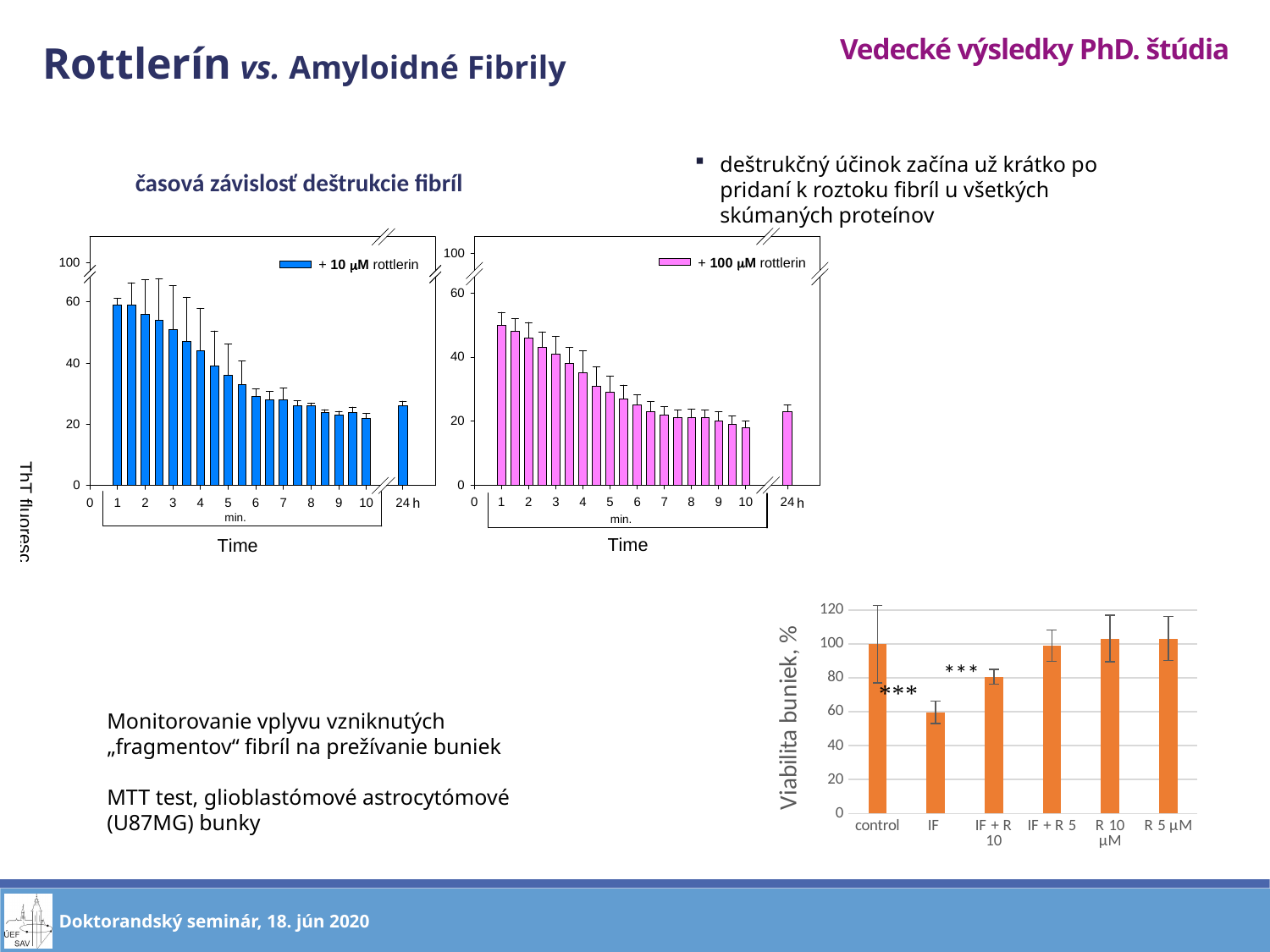
In the left time-dependence chart (+ 10 µM rottlerin), do the values rise or fall as time increases from 1 to 10 min? fall In the left time-dependence chart (+ 10 µM rottlerin), is the value at 1 min greater or less than 40? greater In the right time-dependence chart (+ 100 µM rottlerin), do the values rise or fall from 1 min to 10 min? fall In the cell viability chart at the bottom right, what is the y-axis label? Viabilita buniek, % In the cell viability chart at the bottom right, how many categories are shown on the x axis? 6 In the left time-dependence chart (+ 10 µM rottlerin), which is larger, the value at 1 min or the value at 10 min? 1 min What legend entry is shown in the right time-dependence chart? + 100 µM rottlerin In the cell viability chart at the bottom right, which category has the lowest value? IF In the cell viability chart at the bottom right, is the value for IF greater or less than 80? less What kind of chart is the left time-dependence chart labelled '+ 10 µM rottlerin'? bar chart In the right time-dependence chart (+ 100 µM rottlerin), is the value at 1 min greater or less than 40? greater